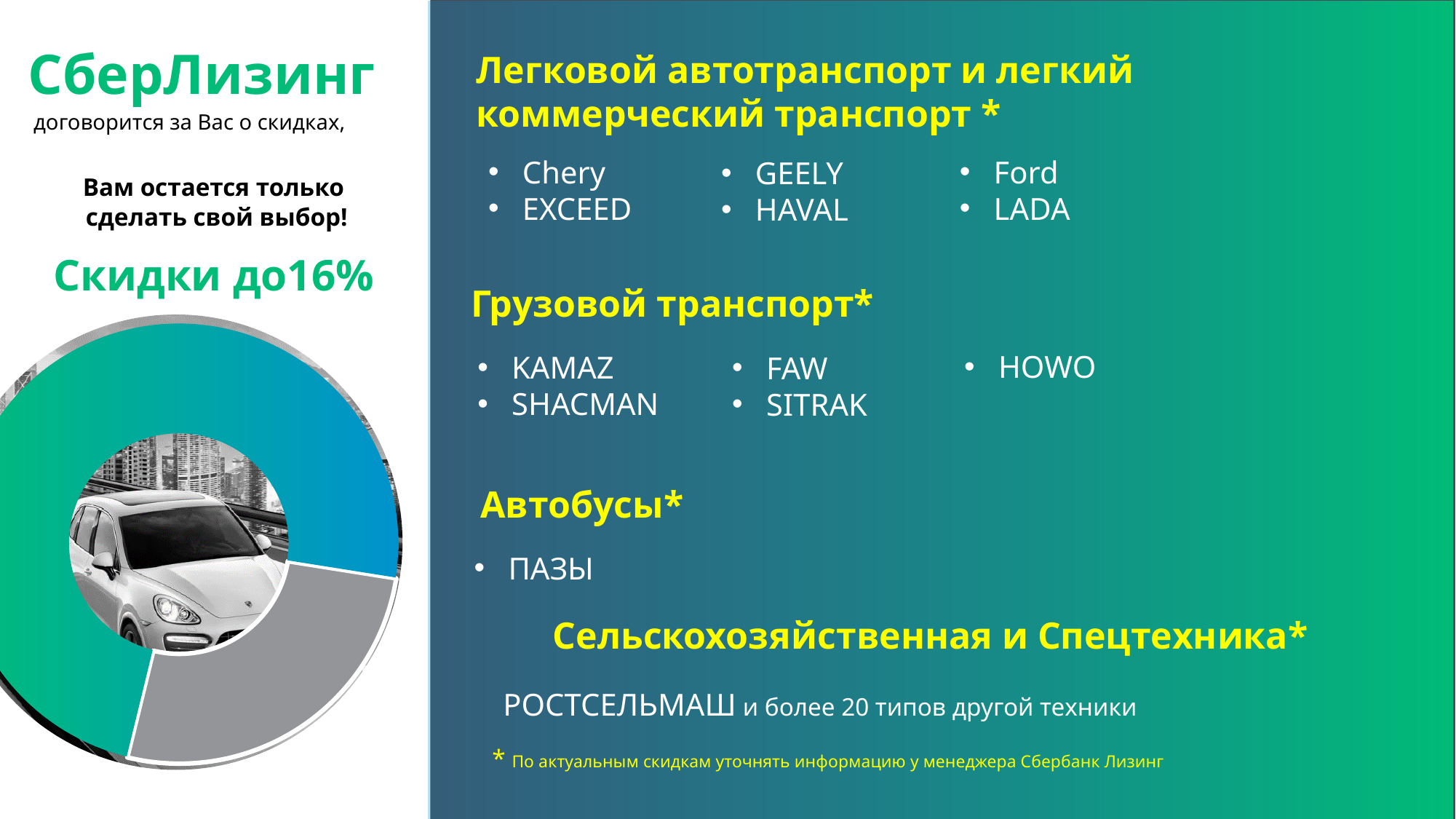
Does the doughnut chart on the left show any data labels or a legend? No How many segments does the doughnut chart on the left have? 2 What kind of chart is shown on the left side of the slide? doughnut chart Which segment of the doughnut chart on the left is the largest? the green-to-blue gradient segment